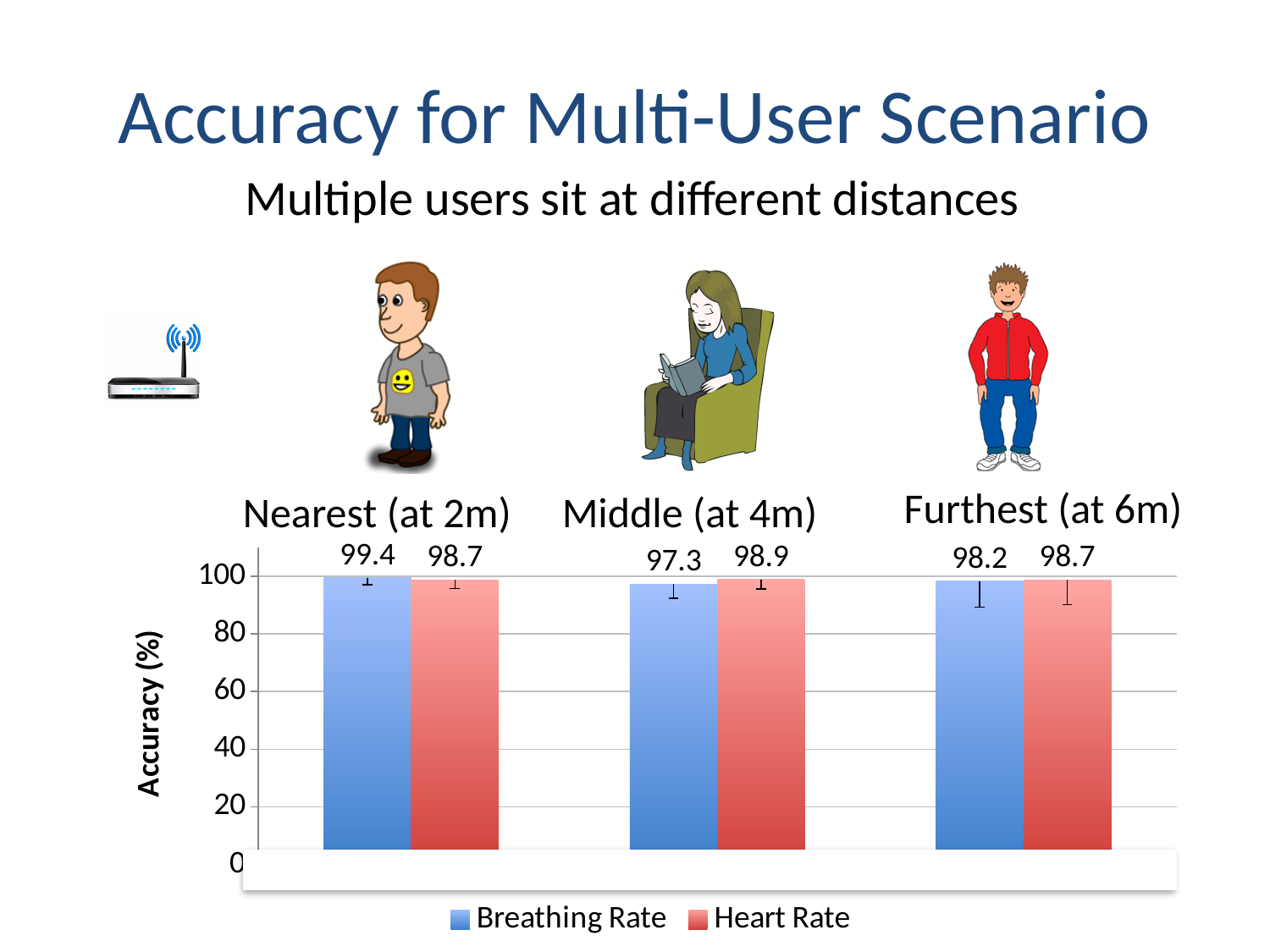
What is the Breathing Rate accuracy for the Nearest (at 2m) user? 99.4 What type of chart is shown on the slide? Bar chart How many series does the chart legend list? 2 What is the difference between the Breathing Rate and Heart Rate accuracy for the Nearest (at 2m) user? 0.7 What is the Heart Rate accuracy for the Furthest (at 6m) user? 98.7 Which user position has the highest Breathing Rate accuracy? Nearest (at 2m) What is the Heart Rate accuracy for the Middle (at 4m) user? 98.9 Which user position has the lowest Breathing Rate accuracy? Middle (at 4m) How many user positions (categories) are shown in the chart? 3 For the Middle (at 4m) user, which is higher: Breathing Rate accuracy or Heart Rate accuracy? Heart Rate What is the difference between the Heart Rate and Breathing Rate accuracy for the Middle (at 4m) user? 1.6 What is the Breathing Rate accuracy for the Furthest (at 6m) user? 98.2